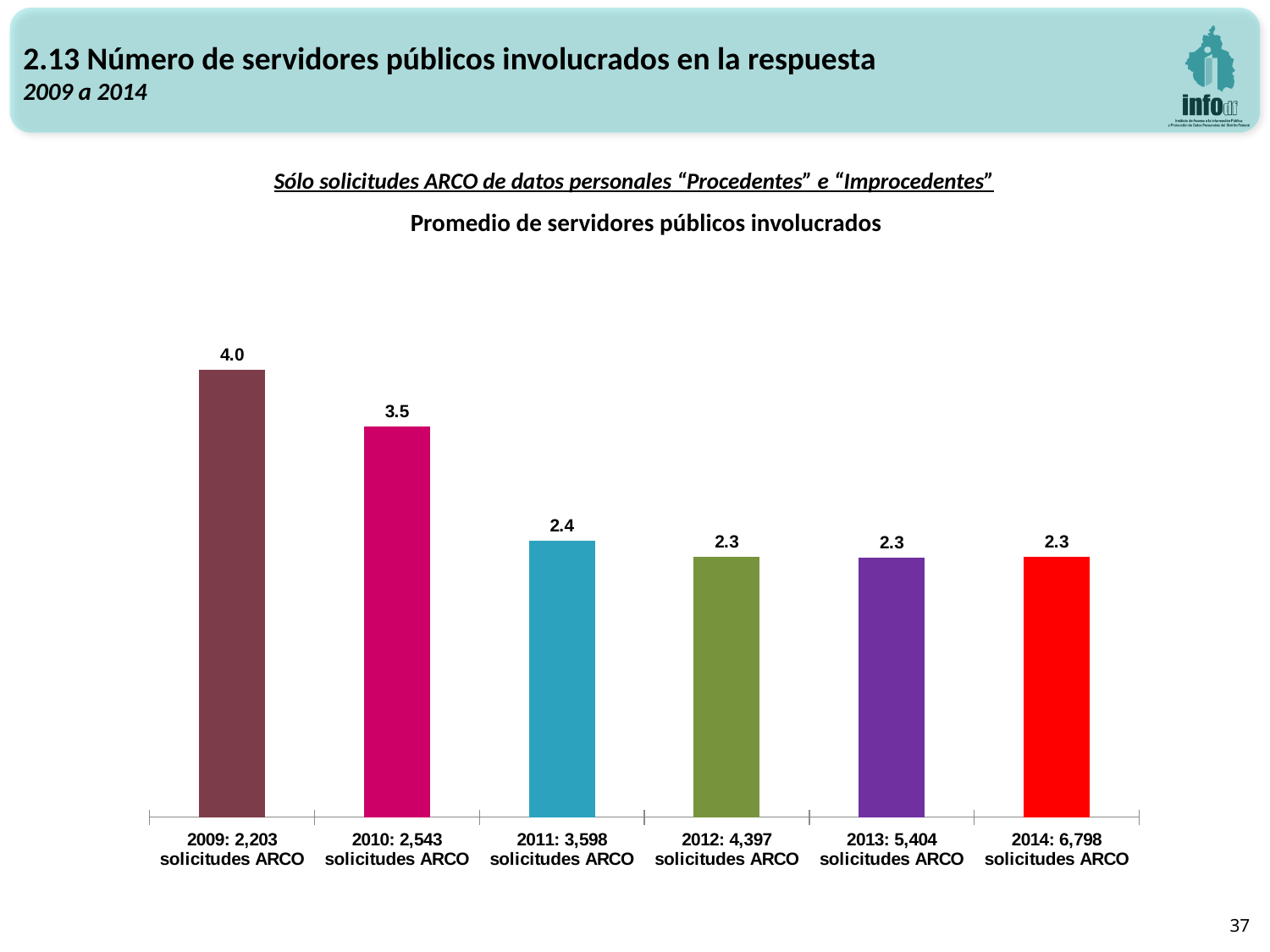
What is the difference between the values for 2009 and 2010? 0.5 What is the title shown above the chart? Promedio de servidores públicos involucrados How many years (bars) are shown in the chart? 6 What is the average number of public servants involved for 2011? 2.4 Do the values generally rise or fall from 2009 to 2014? Fall Which is larger, the value for 2010 or the value for 2012? 2010 Which year has the highest average number of public servants involved? 2009 What kind of chart is shown on the slide? Bar chart What is the average number of public servants involved for 2009? 4.0 What is the difference between the values for 2010 and 2011? 1.1 How many ARCO requests are indicated in the axis label for 2014? 6,798 What is the value shown for 2014? 2.3